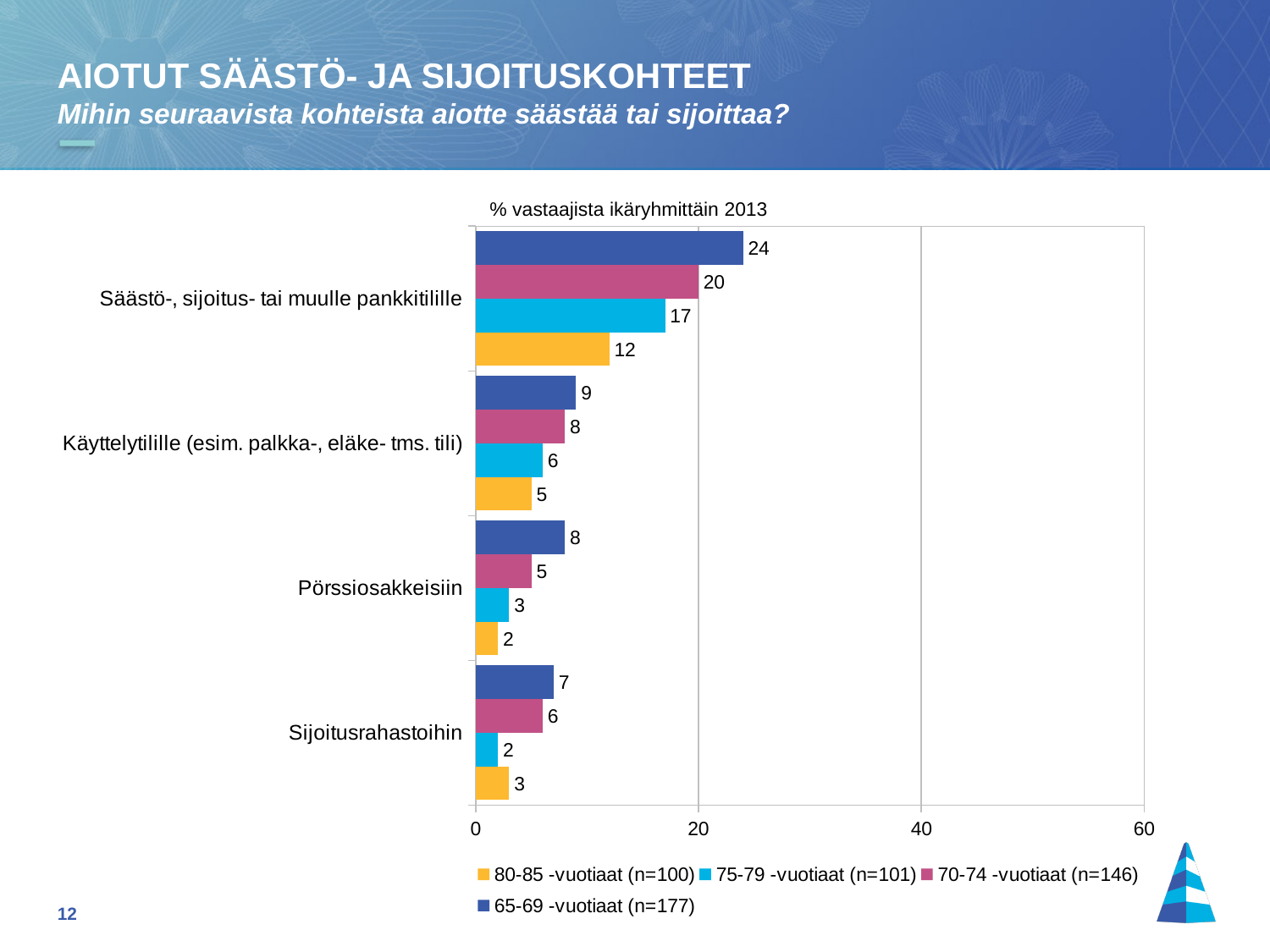
What is the value for 70-74 -vuotiaat for Sijoitusrahastoihin? 6 What is the value for 75-79 -vuotiaat for Käyttelytilille (esim. palkka-, eläke- tms. tili)? 6 What is the value for 80-85 -vuotiaat for Säästö-, sijoitus- tai muulle pankkitilille? 12 How many series does the legend list? 4 Which category has the lowest value for 80-85 -vuotiaat? Pörssiosakkeisiin How many categories are shown on the chart? 4 What is the difference between the 65-69 -vuotiaat and 80-85 -vuotiaat values for Säästö-, sijoitus- tai muulle pankkitilille? 12 Which category has the highest value for 65-69 -vuotiaat? Säästö-, sijoitus- tai muulle pankkitilille What is the title shown above the chart? % vastaajista ikäryhmittäin 2013 For Sijoitusrahastoihin, which is larger: the value for 75-79 -vuotiaat or for 80-85 -vuotiaat? 80-85 -vuotiaat What is the value for 65-69 -vuotiaat for Säästö-, sijoitus- tai muulle pankkitilille? 24 What kind of chart is shown on the slide? bar chart